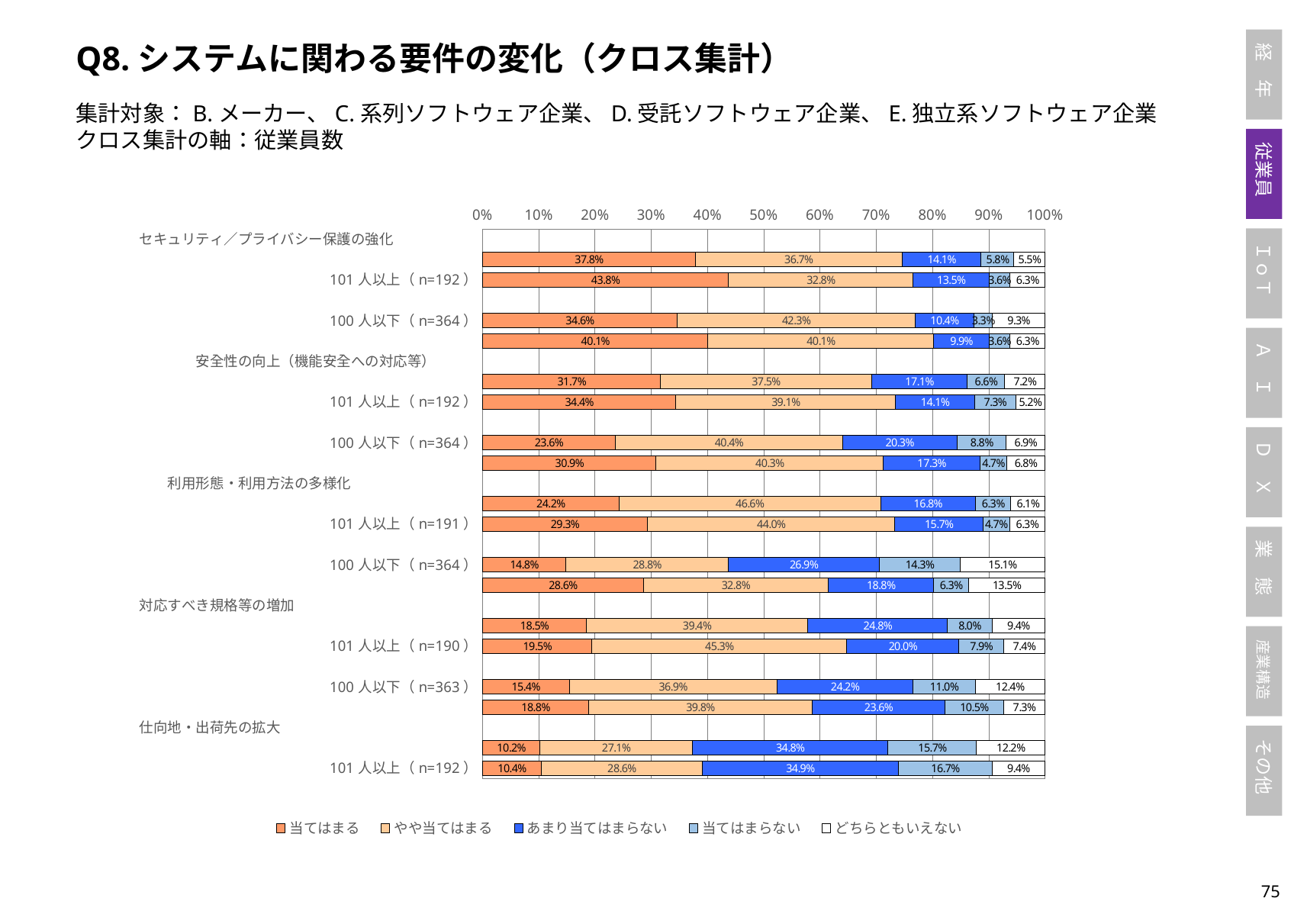
What is the highest 当てはまる value shown in the chart? 43.8% What is the あまり当てはまらない value for the bottom bar in the chart? 34.9% What kind of chart is shown on the slide? bar chart What is the first entry in the legend? 当てはまる What is the maximum value shown on the horizontal axis? 100% What is the lowest 当てはまる value shown in the chart? 10.2% In the topmost bar, which is larger: 当てはまる or やや当てはまる? 当てはまる In the topmost bar, what is the difference between the 当てはまる value and the やや当てはまる value? 1.1% What is the どちらともいえない value for the bottom bar in the chart? 9.4% What is the 当てはまる value for the topmost bar in the chart? 37.8% How many series does the legend list? 5